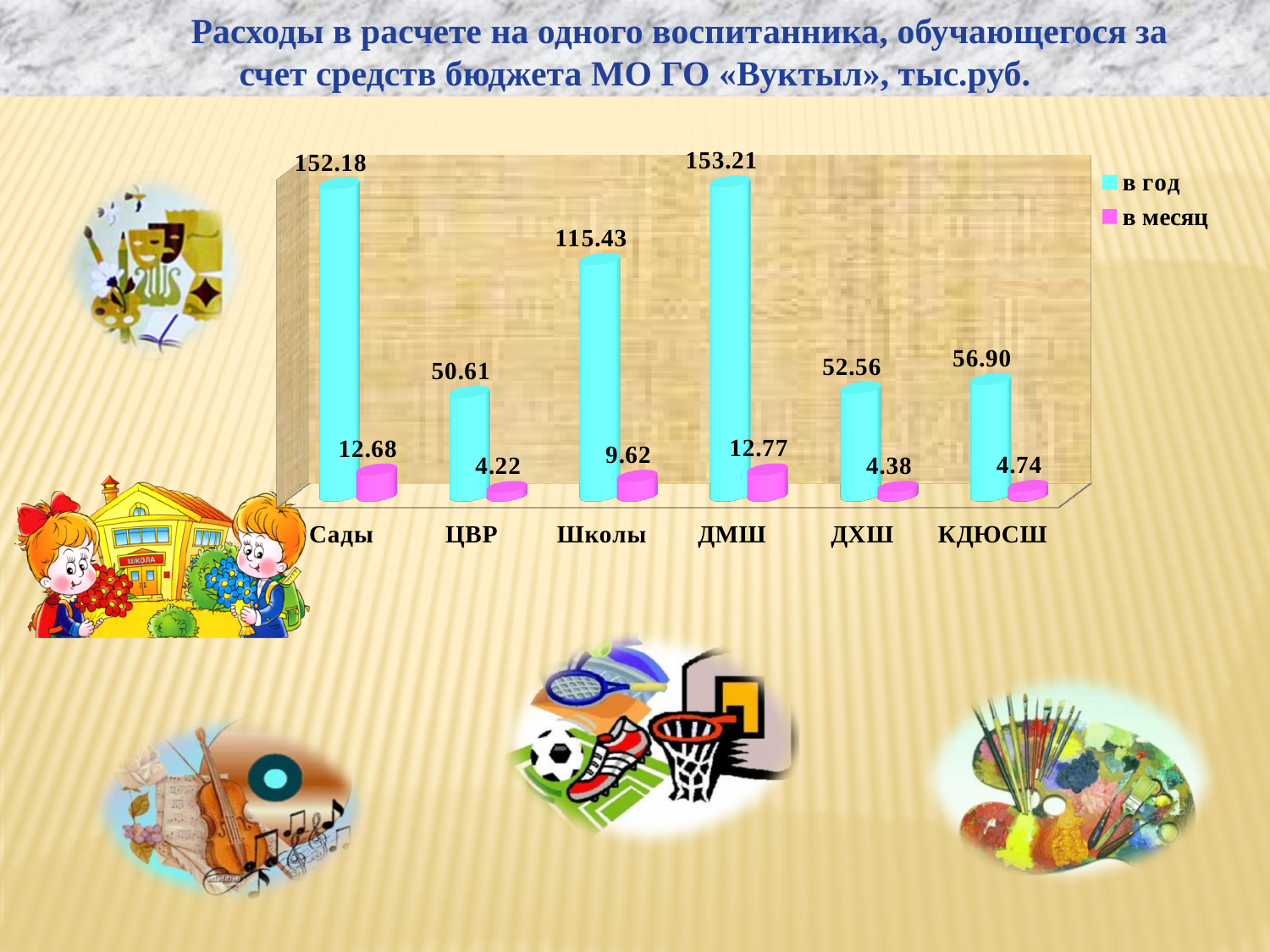
Which category has the lowest value in the 'в месяц' series? ЦВР How many categories are shown on the x axis? 6 Which is larger in the 'в год' series: Школы or ДХШ? Школы What is the value for Сады in the 'в год' series? 152.18 Which category has the lowest value in the 'в год' series? ЦВР Which category has the highest value in the 'в год' series? ДМШ What is the difference between the 'в год' values for Сады and ЦВР? 101.57 What is the value for ДМШ in the 'в месяц' series? 12.77 What is the value for Школы in the 'в год' series? 115.43 How many series does the legend list? 2 What is the value for КДЮСШ in the 'в месяц' series? 4.74 What kind of chart is shown on the slide? Bar chart